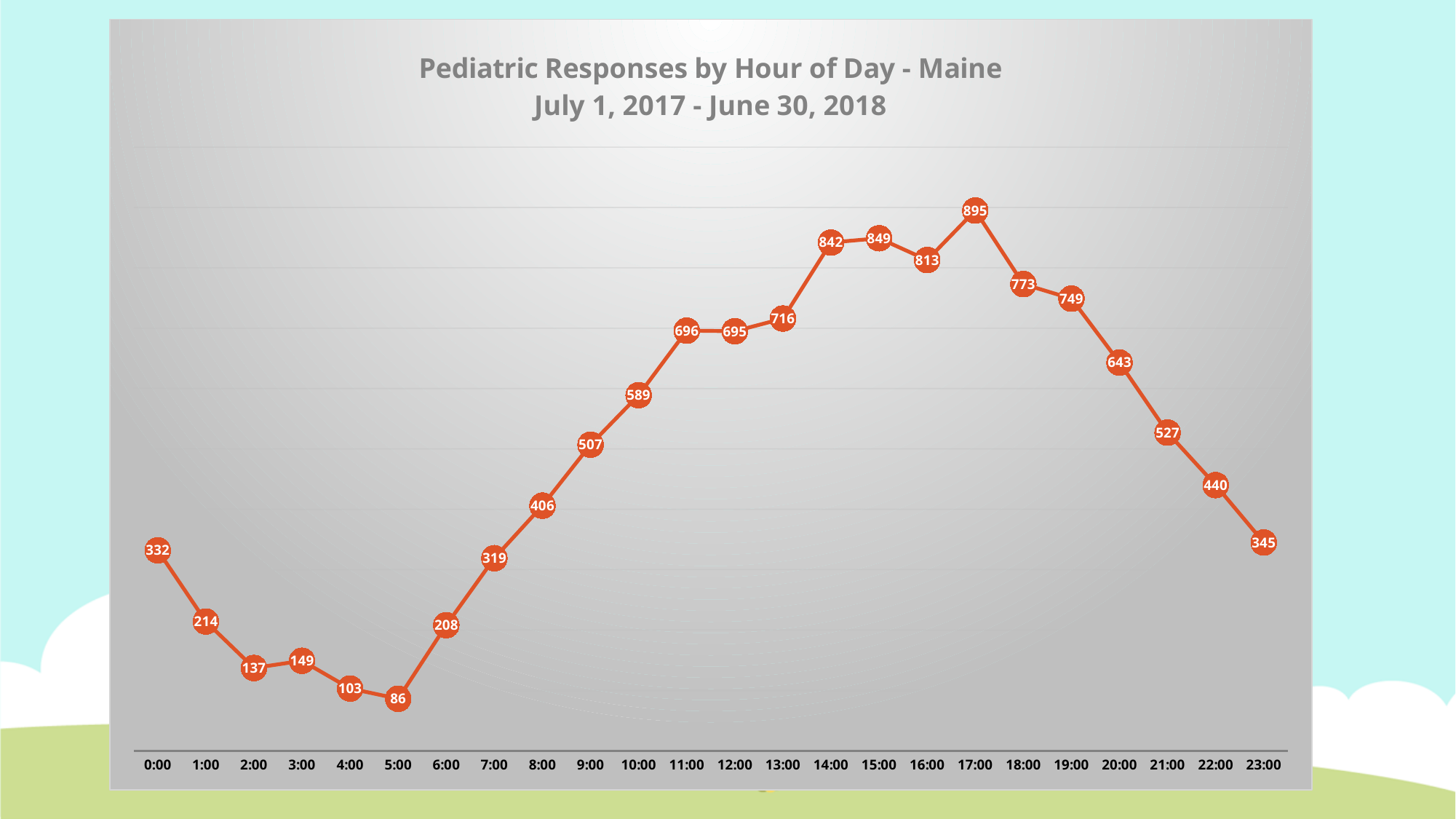
What is the difference between the values at 23:00 and 0:00? 13 Which hour has the highest value? 17:00 What kind of chart is this? Line chart Which hour has the lowest value? 5:00 What is the value at 5:00? 86 What is the value at 12:00? 695 How many hourly data points are plotted? 24 What is the value at 0:00? 332 What is the value at 17:00? 895 What is the difference between the values at 17:00 and 5:00? 809 Which is larger, the value at 14:00 or the value at 18:00? 14:00 Do the values rise or fall from 5:00 to 14:00? Rise